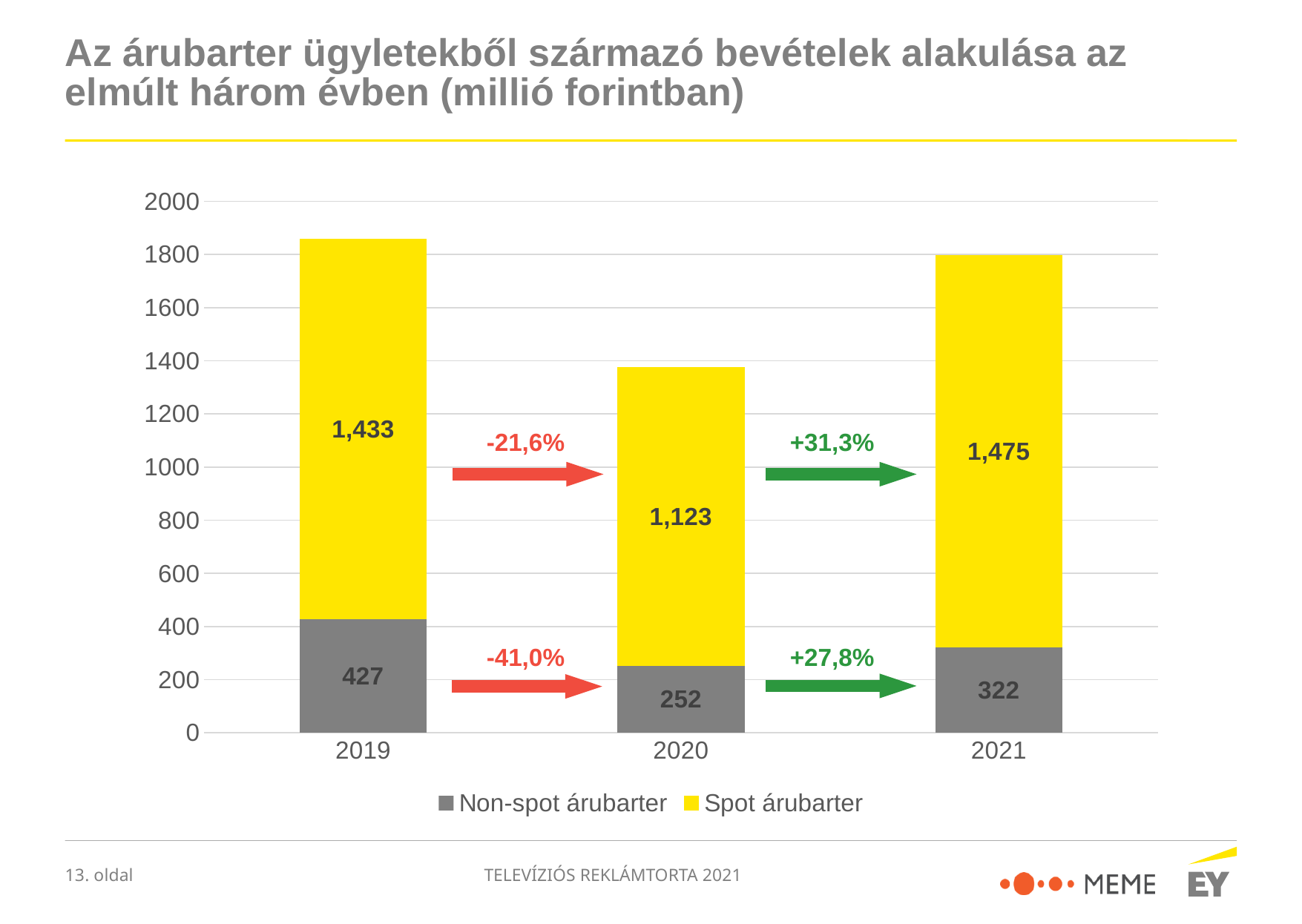
What is the total of the stacked bar for 2019? 1,860 What is the value of Non-spot árubarter in 2021? 322 How many years are shown on the x axis? 3 Is the Non-spot árubarter value for 2019 larger or smaller than the Non-spot árubarter value for 2021? larger Which year has the lowest Non-spot árubarter value? 2020 How many series does the legend list? 2 What is the total of the stacked bar for 2020? 1,375 What is the value of Spot árubarter in 2020? 1,123 What type of chart is shown on the slide? stacked bar chart What is the difference between the Non-spot árubarter values for 2019 and 2020? 175 Which year has the highest Spot árubarter value? 2021 What percentage change is shown by the arrow between the Spot árubarter values for 2020 and 2021? +31,3%